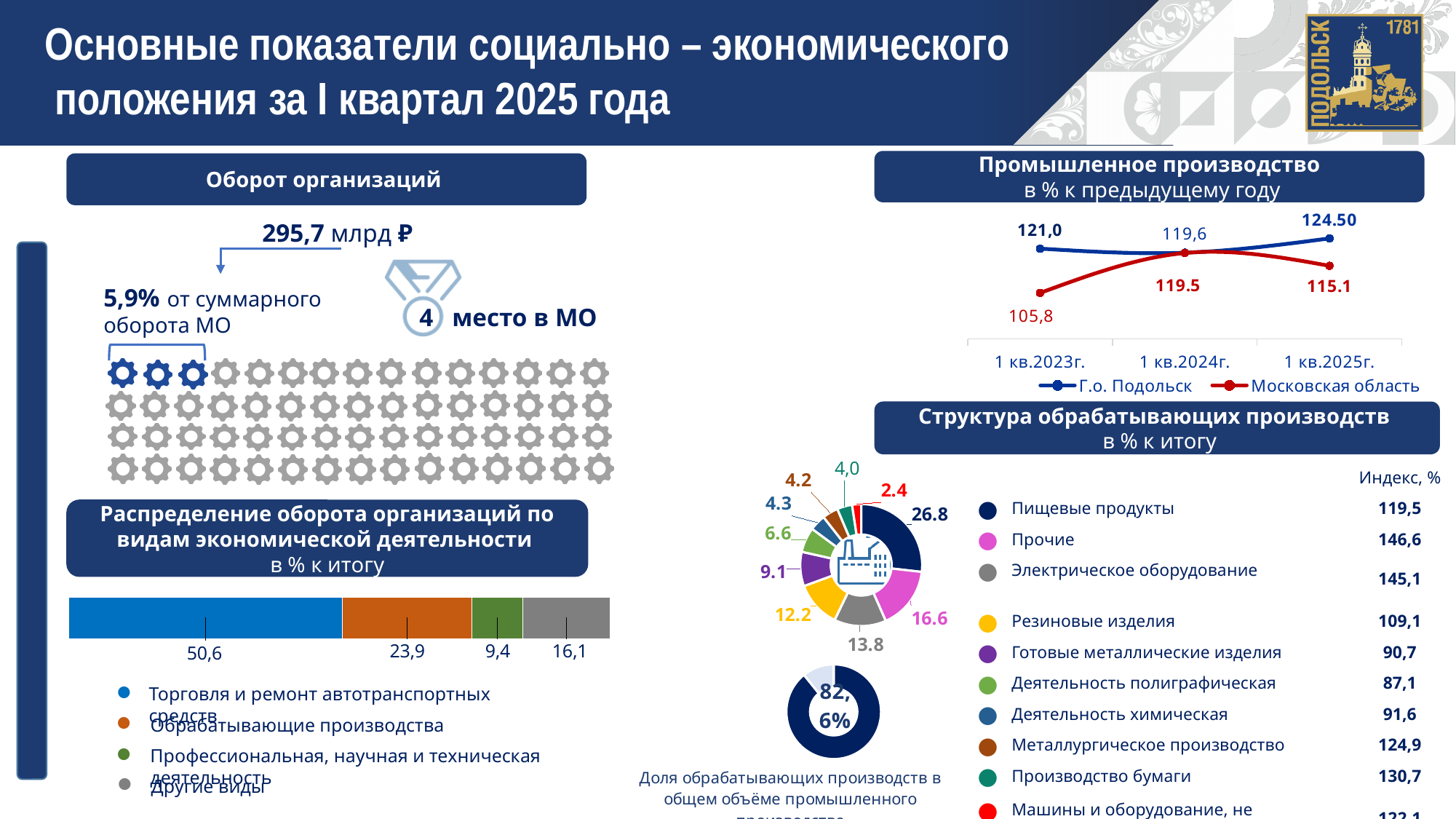
In the 'Промышленное производство' chart, what is the value for Московская область in 1 кв.2023г.? 105,8 In the 'Промышленное производство' chart, how many time periods are shown on the x axis? 3 In the 'Промышленное производство' chart, what kind of chart is it? line chart In the 'Структура обрабатывающих производств' donut chart, what is the share for Пищевые продукты? 26.8 In the 'Промышленное производство' chart, how many series does the legend list? 2 In the 'Распределение оборота организаций по видам экономической деятельности' chart, what is the value for Обрабатывающие производства? 23,9 In the 'Структура обрабатывающих производств' donut chart, what is the difference between the shares of Прочие and Электрическое оборудование? 2.8 In the 'Распределение оборота организаций по видам экономической деятельности' chart, which category has the smallest share? Профессиональная, научная и техническая деятельность In the 'Промышленное производство' chart, which series has the higher value in 1 кв.2025г.? Г.о. Подольск In the 'Распределение оборота организаций по видам экономической деятельности' chart, which category has the largest share? Торговля и ремонт автотранспортных средств In the 'Промышленное производство' chart, what is the value for Г.о. Подольск in 1 кв.2025г.? 124.50 In the 'Структура обрабатывающих производств' table, what is the Индекс, % for Прочие? 146,6